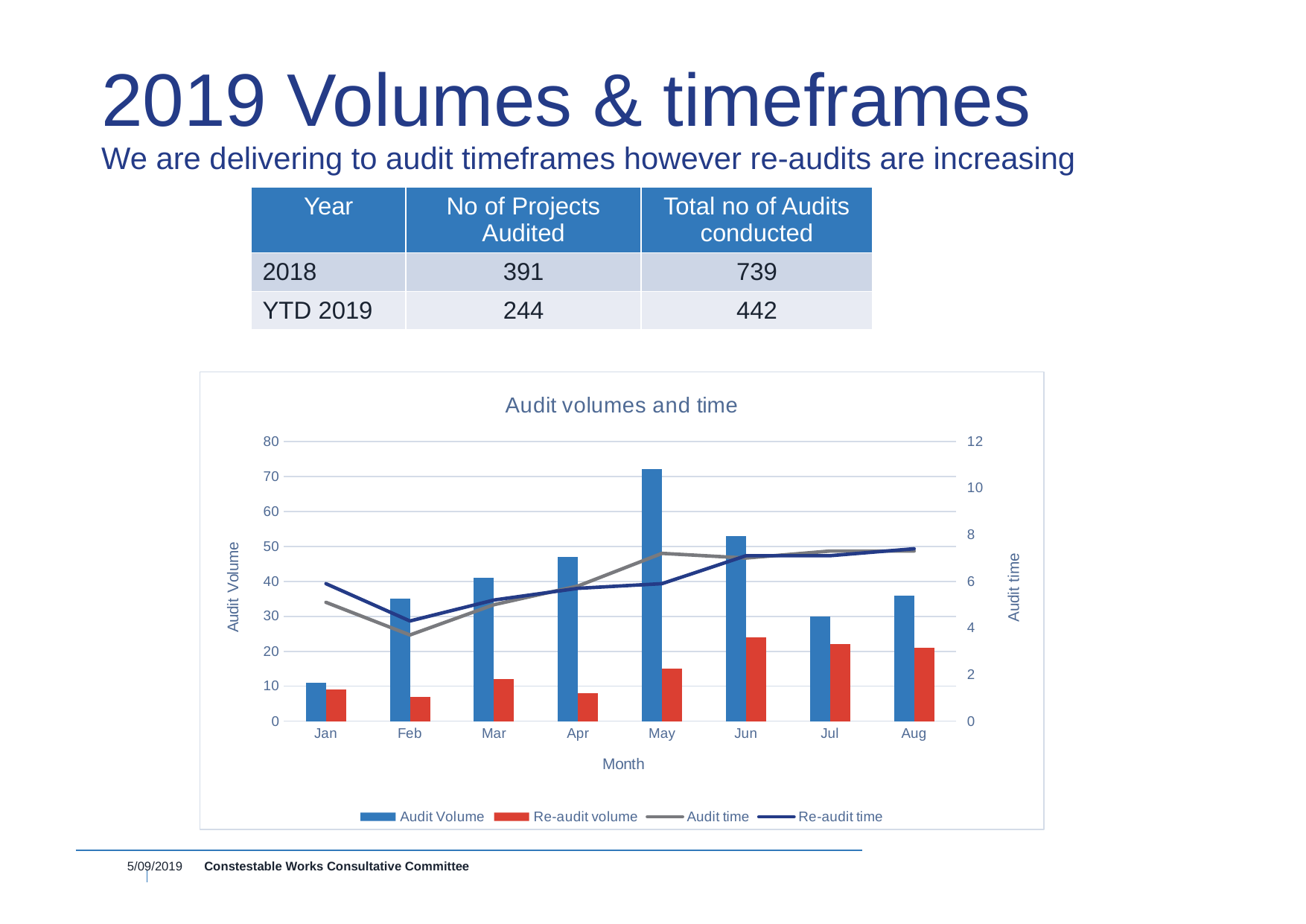
Which month has the highest Audit Volume? May Which month has the lowest Audit Volume? Jan How many months are shown on the x axis of the chart? 8 Is the Audit Volume for Jan greater or less than 20? less What kind of chart is shown on the slide? Combined bar and line chart Which month has the larger Audit Volume, Jun or Jul? Jun Is the Re-audit volume for Jun greater or less than 20? greater Is the Audit Volume for May greater or less than 60? greater What is the title of the chart? Audit volumes and time Which month has the highest Re-audit volume? Jun Does the Audit Volume rise or fall from Jan to May? rise How many series does the chart legend list? 4